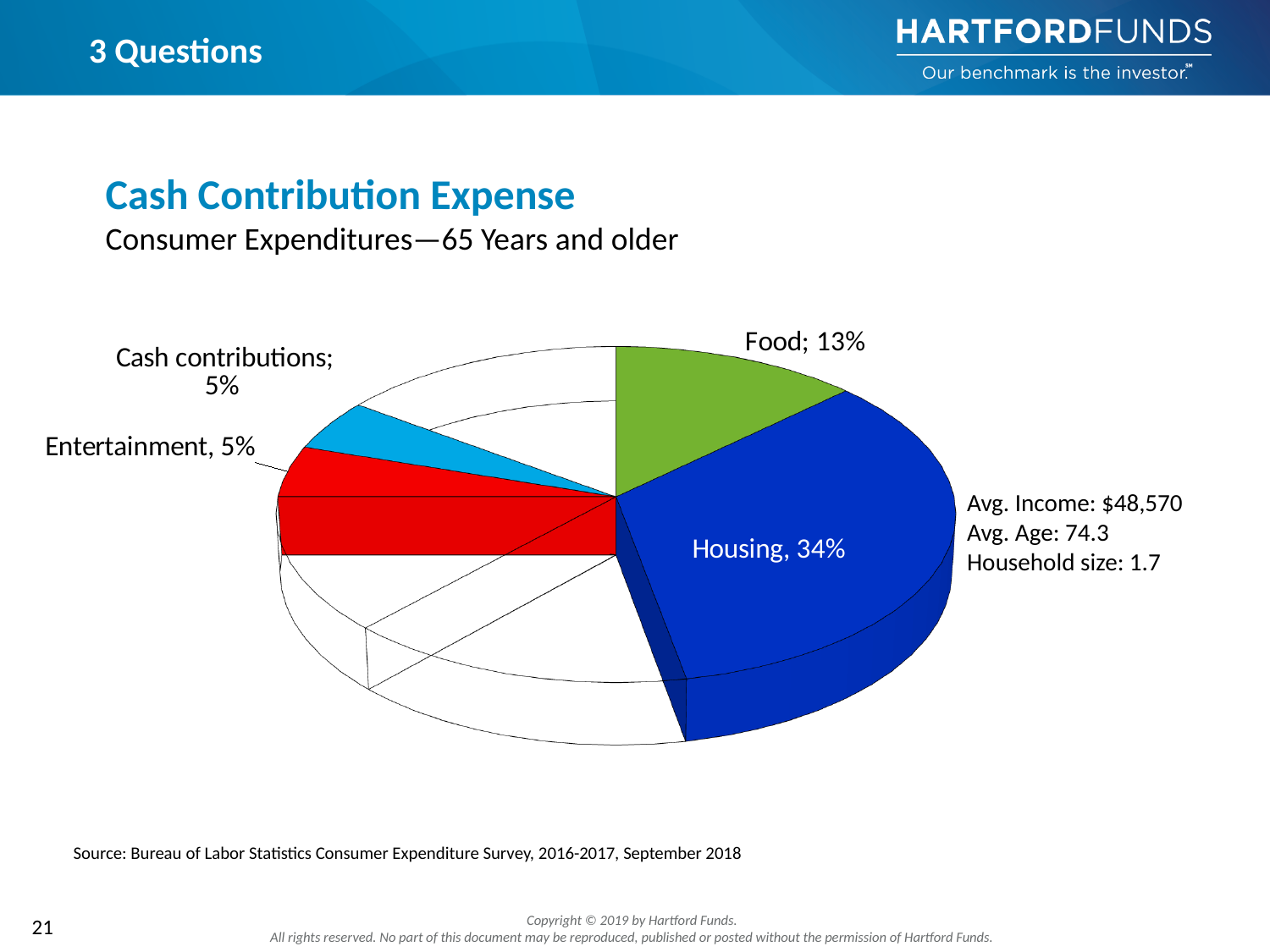
What share of the pie does Housing represent? 34% What is the difference in percentage points between Housing and Entertainment? 29% Which is larger, the share for Food or the share for Cash contributions? Food Which labeled category has the largest share of the pie? Housing What is the title of the chart? Cash Contribution Expense Which is larger, the share for Housing or the share for Food? Housing What is the difference in percentage points between Housing and Food? 21% What percentage is shown for Entertainment? 5% What kind of chart is shown on the slide? Pie chart What colour is the Housing slice? Blue What percentage is shown for Cash contributions? 5% What percentage is shown for Food? 13%